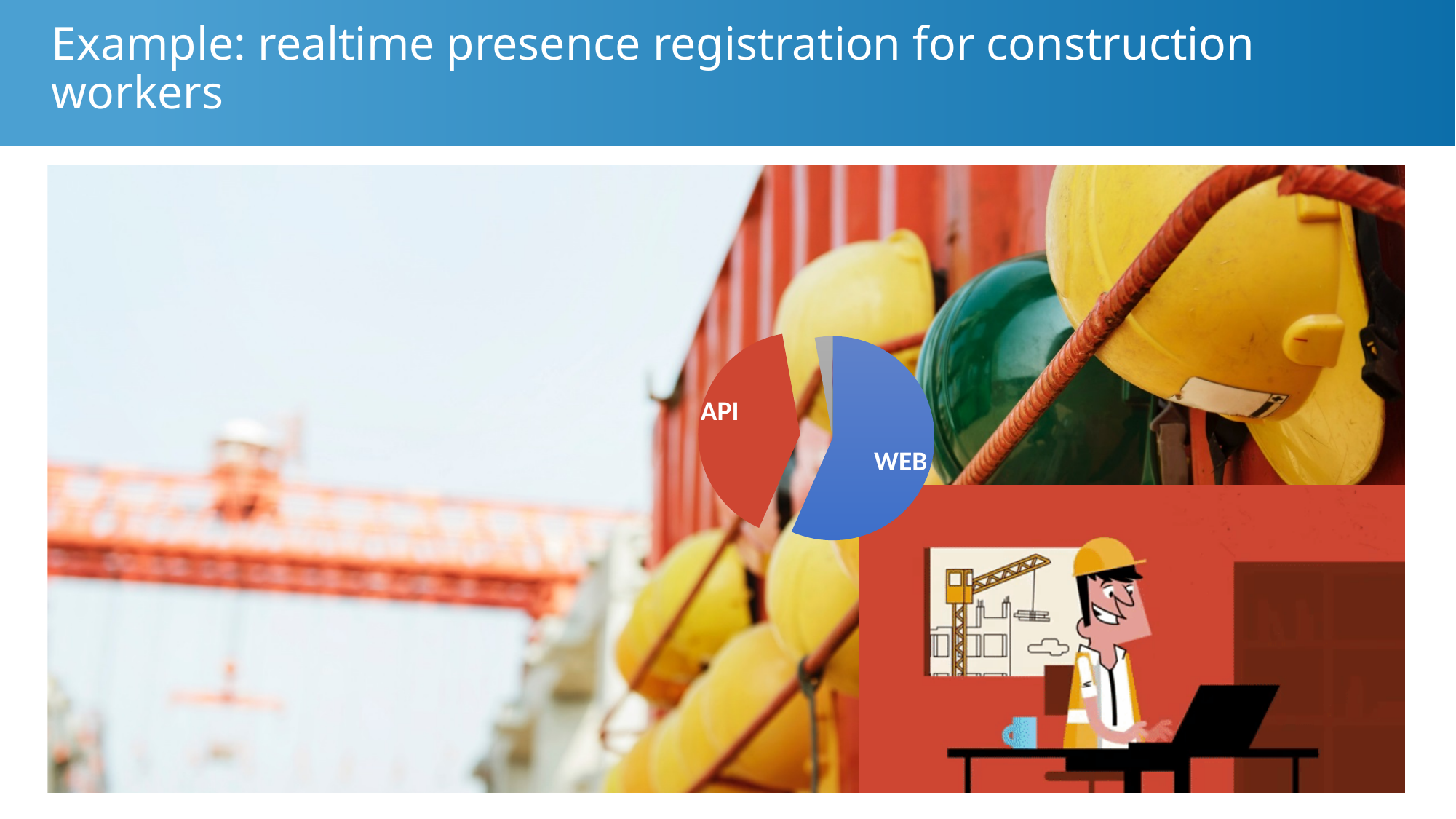
What colour is the WEB slice of the pie chart? blue What colour is the API slice of the pie chart? red How many slices of the pie chart are labelled? 2 Which labelled slice of the pie chart is the largest? WEB What kind of chart is shown on the slide? pie chart Which labelled slice of the pie chart is larger, API or WEB? WEB How many slices does the pie chart have? 3